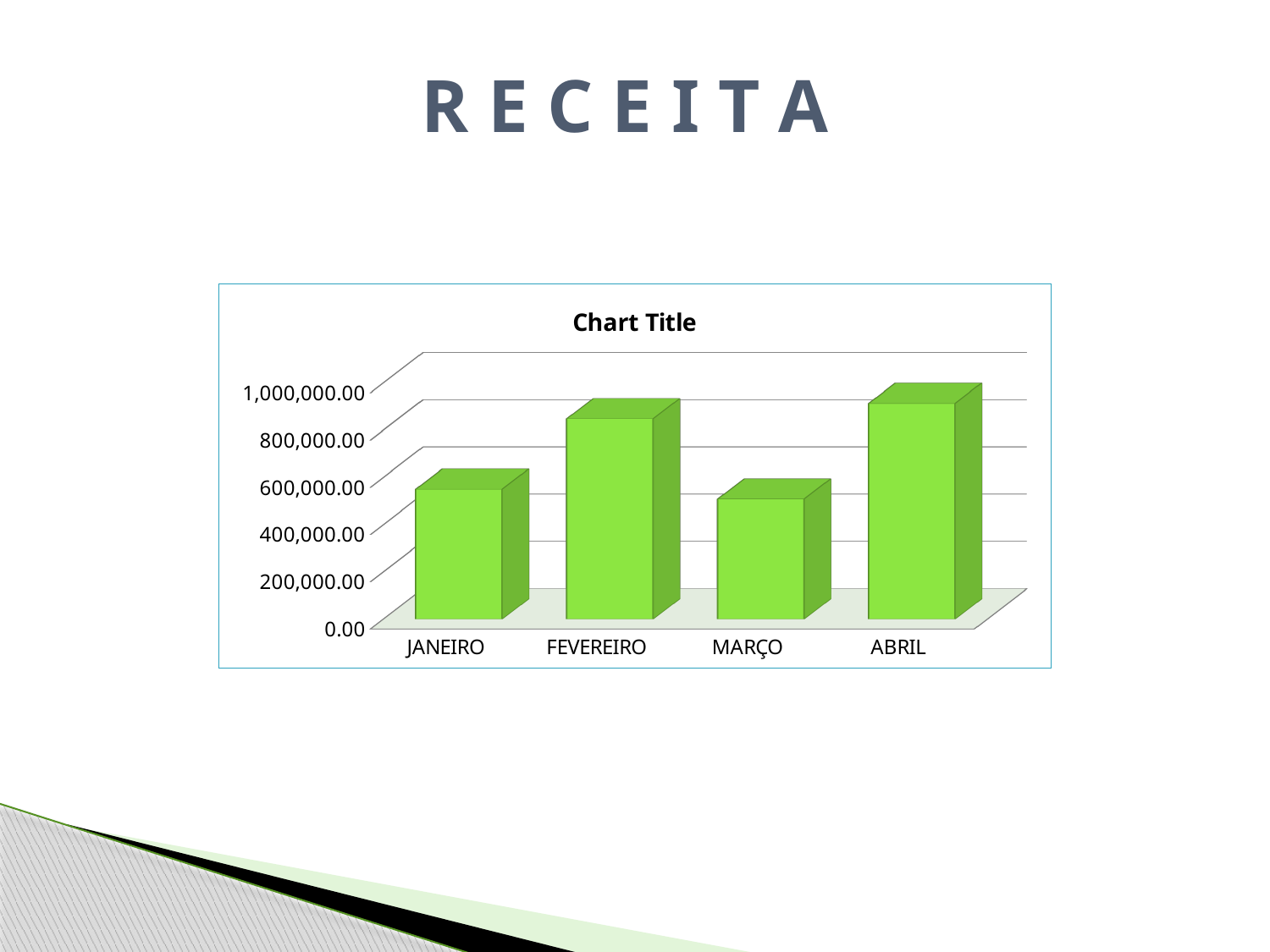
What kind of chart is shown on the slide? bar chart Is the value for MARÇO greater or less than 800,000.00? less Which is larger, the value for ABRIL or the value for MARÇO? ABRIL Which month has the highest value in the chart? ABRIL How many categories are shown on the x axis of the chart? 4 Is the value for FEVEREIRO greater or less than 600,000.00? greater Is the value for JANEIRO greater or less than 800,000.00? less What is the title printed above the chart? Chart Title Which is larger, the value for FEVEREIRO or the value for JANEIRO? FEVEREIRO Does the value rise or fall from MARÇO to ABRIL? rise Which month has the lowest value in the chart? MARÇO